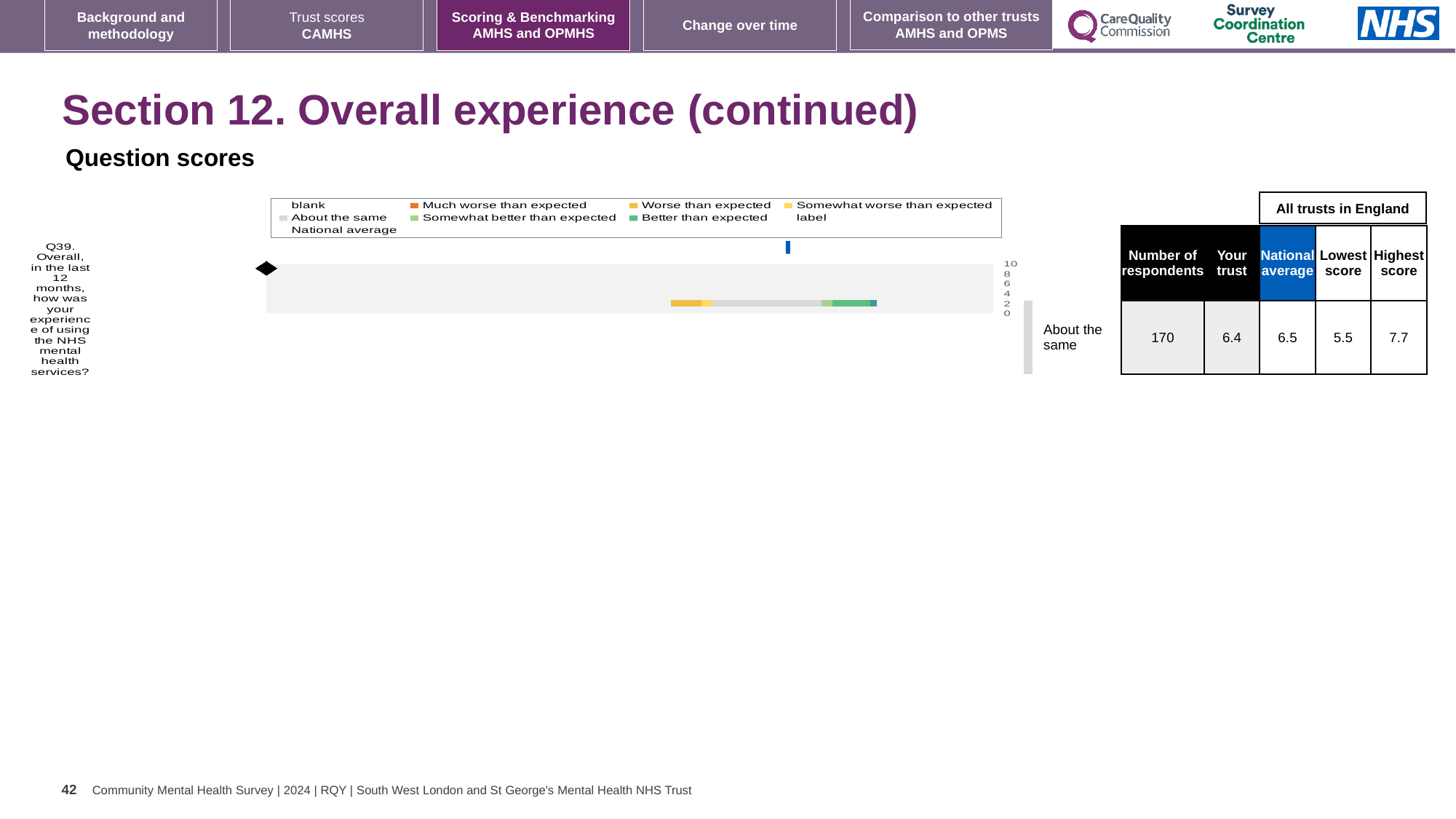
Which benchmark category is the trust's Q39 score placed in, according to the label beside the chart? About the same In the table next to the chart, what is the number of respondents for Q39? 170 Which question number is plotted on the chart? Q39 In the table next to the chart, what is the national average score for Q39? 6.5 In the table next to the chart, what is the lowest score among all trusts in England for Q39? 5.5 What kind of chart is shown on the slide? bar chart What is the difference between the highest score and the lowest score for Q39 in the table? 2.2 In the table next to the chart, what is the 'Your trust' score for Q39? 6.4 Is the 'Your trust' score for Q39 larger or smaller than the national average? smaller Which legend entry on the chart is shown in grey? About the same In the table next to the chart, what is the highest score among all trusts in England for Q39? 7.7 How many survey questions are plotted on the chart? 1